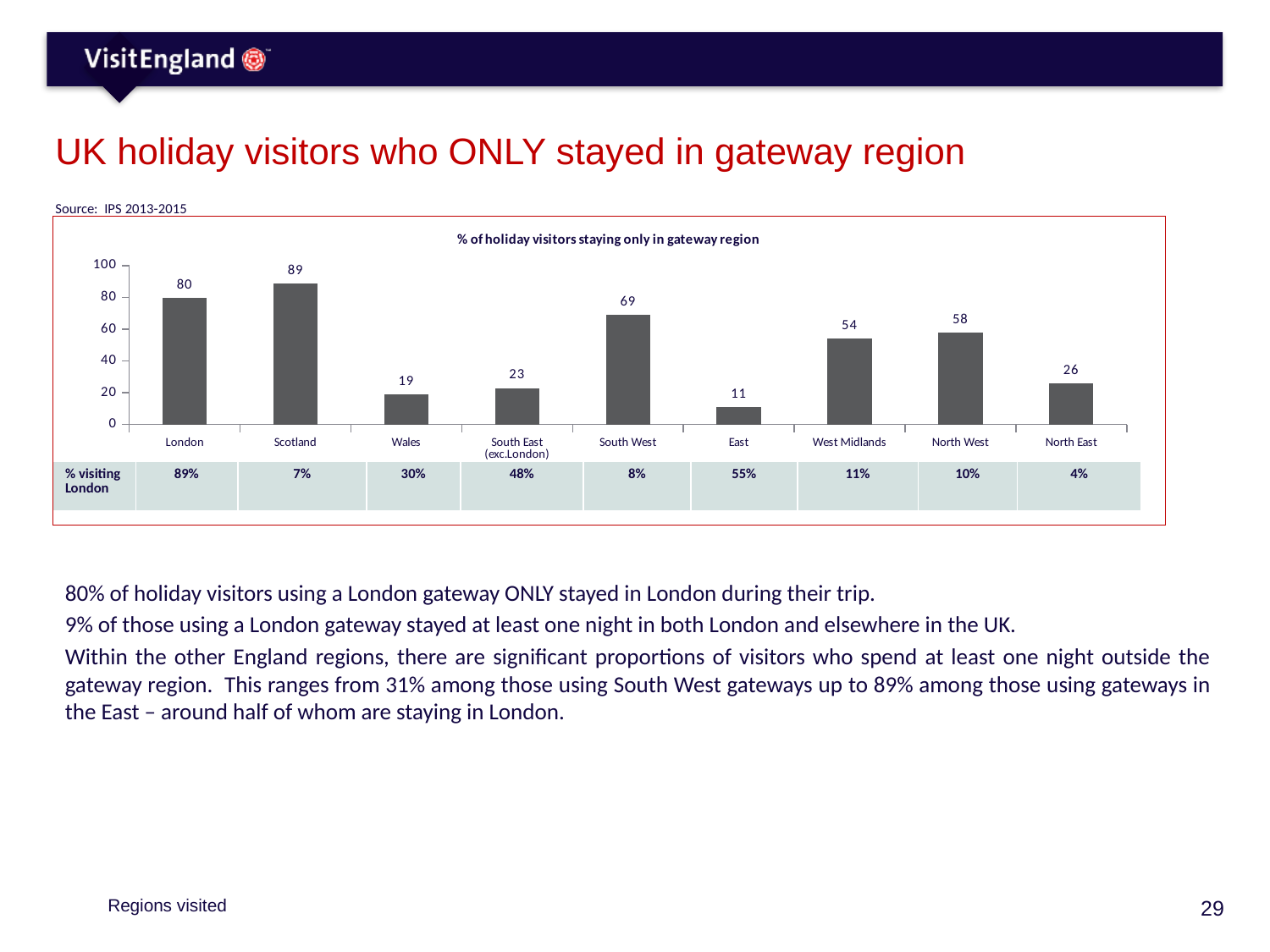
Which has a larger value, South West or West Midlands? South West How many regions are shown in the chart? 9 Is the value for North East greater or less than 40? less What is the difference between the values for London and Wales? 61 Which region has the highest value in the chart? Scotland What is the title of the chart? % of holiday visitors staying only in gateway region What is the value for North West in the chart? 58 What is the value for East in the chart? 11 What is the value for Scotland in the chart? 89 What is the '% visiting London' figure shown beneath the South East (exc.London) bar? 48% Which region has the lowest value in the chart? East What kind of chart is shown on the slide? bar chart